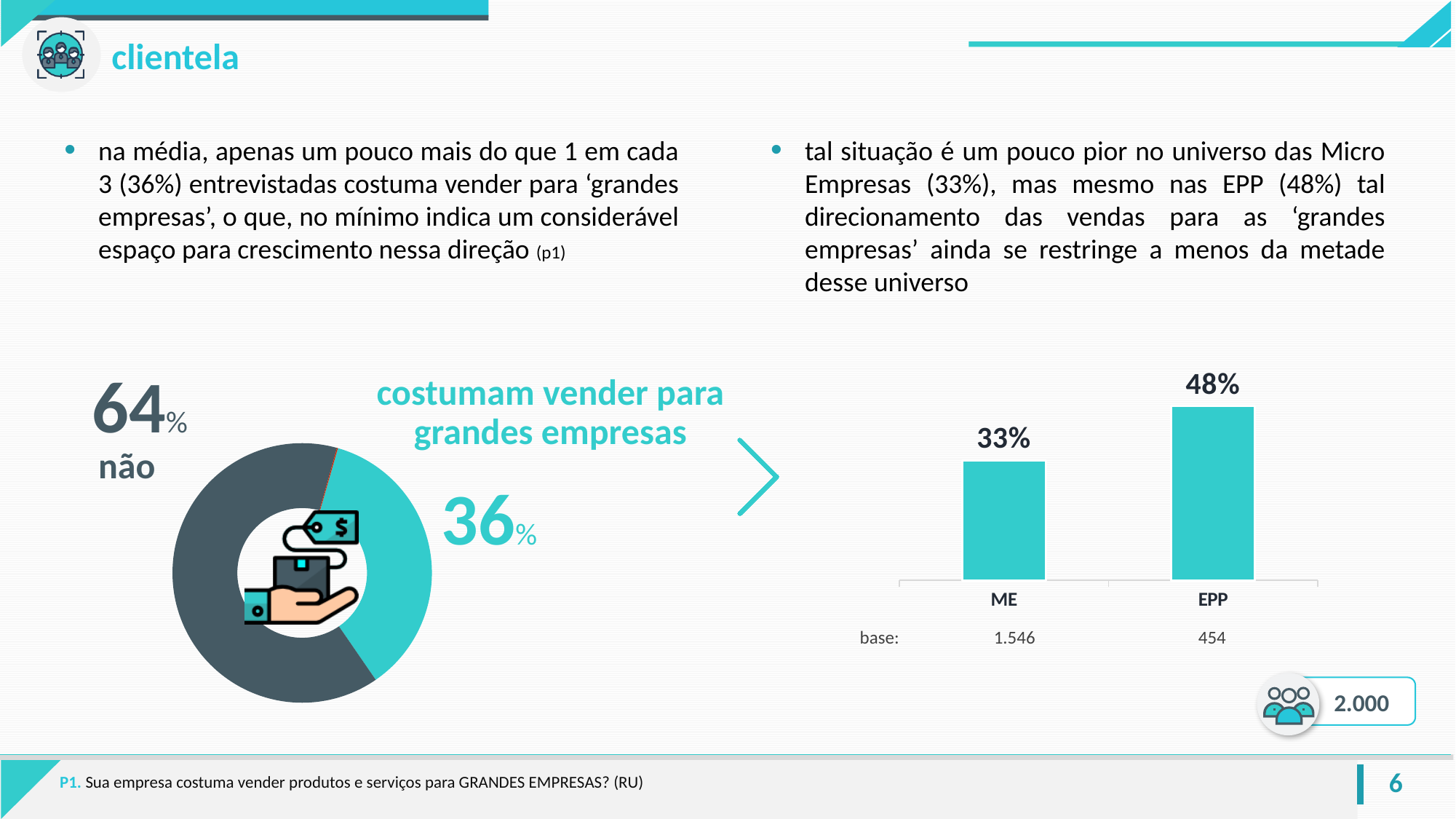
In the donut chart on the left, what share of respondents answered 'não'? 64% In the donut chart on the left, what is the difference between the 'não' share and the 'costumam vender para grandes empresas' share? 28 percentage points In the bar chart on the right, what is the value for EPP? 48% How many categories are shown in the bar chart on the right? 2 In the bar chart on the right, what is the difference between the EPP and ME values? 15 percentage points What kind of chart is shown on the left of the slide? Donut (pie) chart In the bar chart on the right, what is the value for ME? 33% In the bar chart on the right, which category has the highest value? EPP In the bar chart on the right, which category has the lowest value? ME In the donut chart on the left, which slice is larger: 'não' or 'costumam vender para grandes empresas'? não In the bar chart on the right, what is the base (number of respondents) shown for ME? 1.546 In the donut chart on the left, what share of respondents 'costumam vender para grandes empresas'? 36%